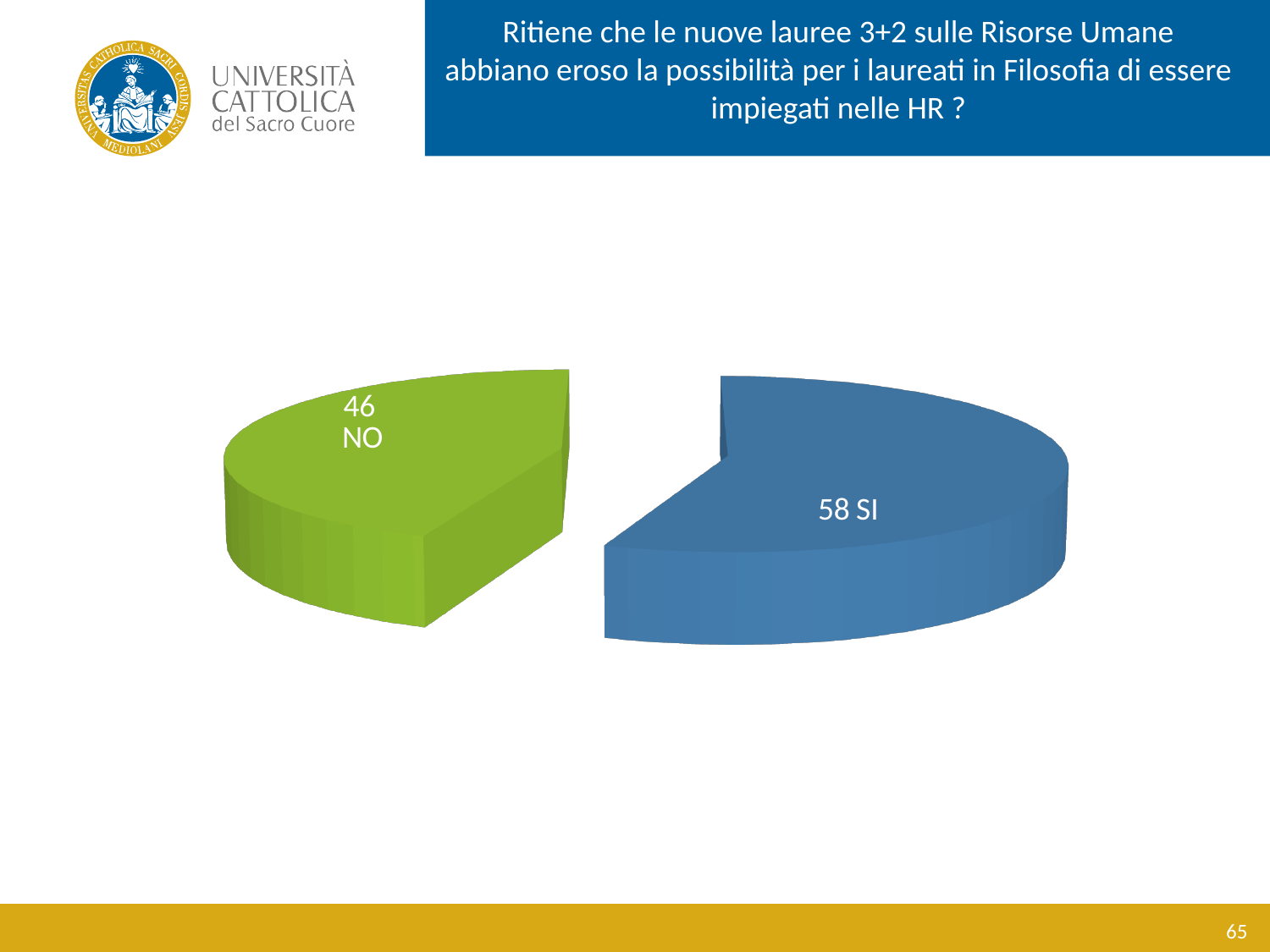
What share of the total does the SI slice represent, as a fraction of responses? 58 out of 104 What is the total of all slices in the pie chart? 104 What is the value for the NO slice? 46 What colour is the SI slice? Blue Which slice is the largest? SI What colour is the NO slice? Green How many slices does the pie chart have? 2 What is the difference between the SI and NO values? 12 What kind of chart is shown on the slide? Pie chart What is the value for the SI slice? 58 Which slice is the smallest? NO Which is larger, SI or NO? SI